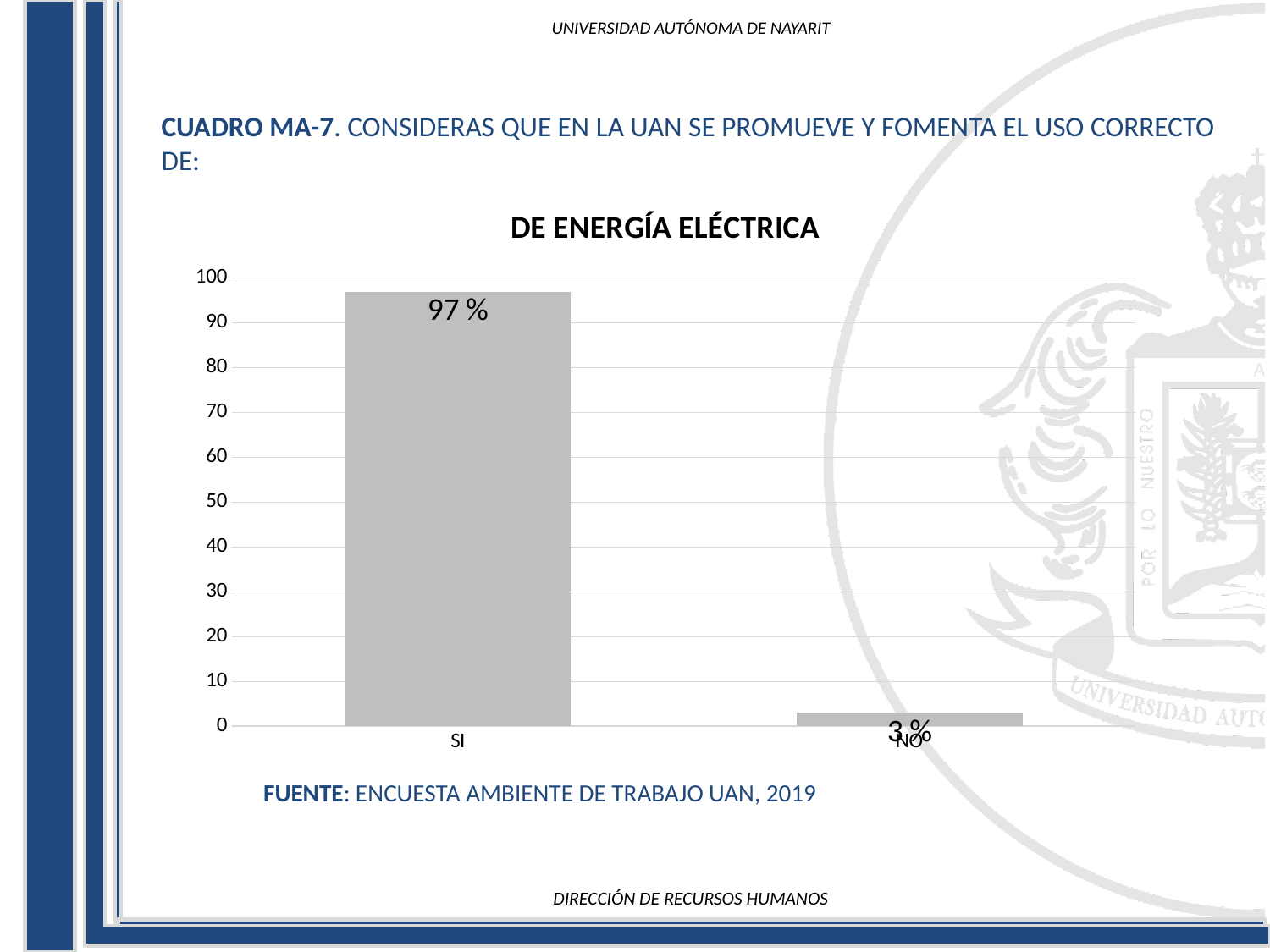
Which category has the highest value? SI What is the difference between the values for SI and NO? 94 % What is the value for SI? 97 % What is the value for NO? 3 % Which category has the lowest value? NO Which is larger, the value for SI or the value for NO? SI What kind of chart is shown? bar chart What is the title of the chart? DE ENERGÍA ELÉCTRICA Is the value for SI greater or less than 90? greater What is the highest value shown on the y axis? 100 Is the value for NO greater or less than 10? less How many categories are shown on the x axis? 2